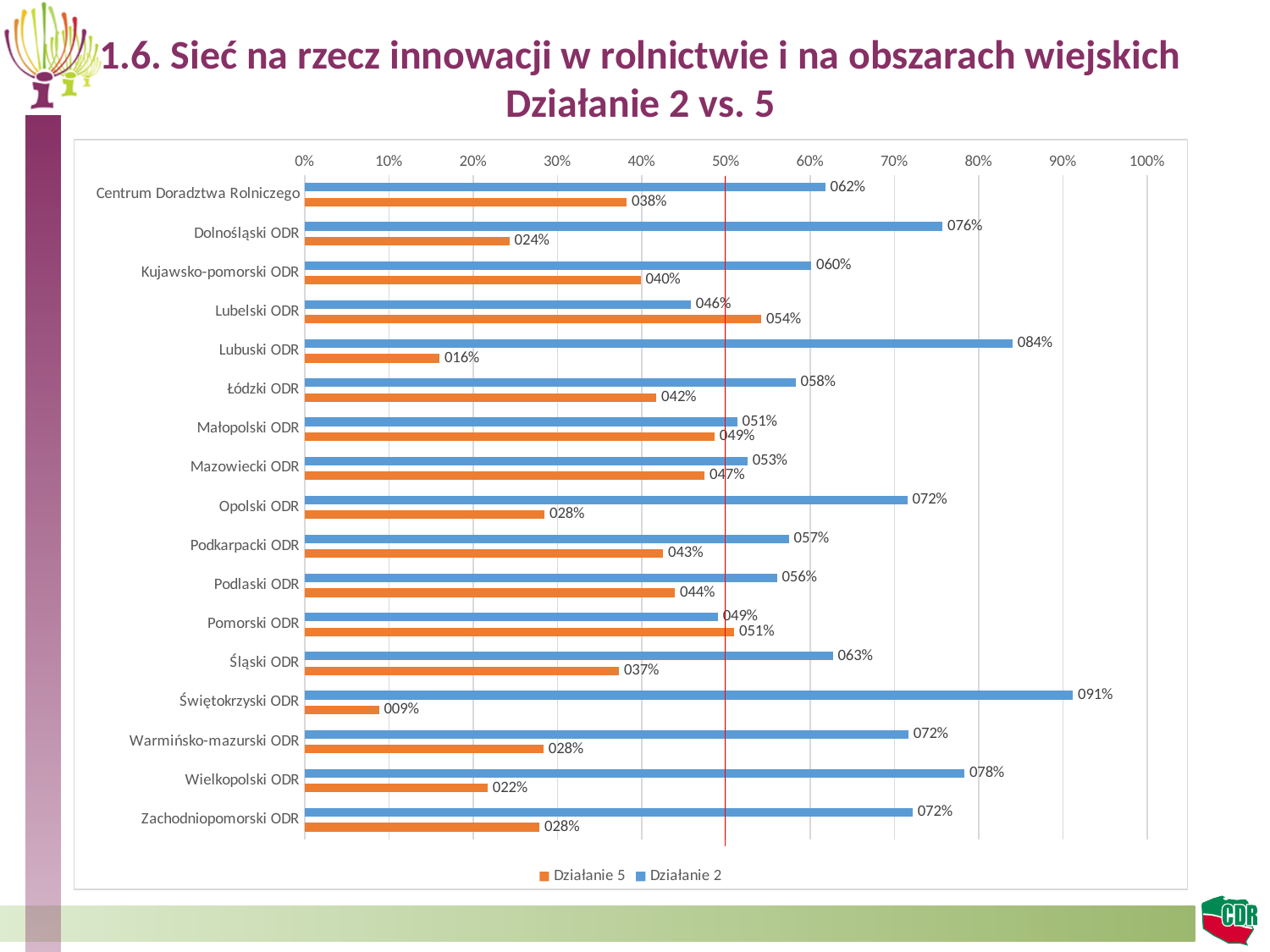
Which category has the highest Działanie 2 value? Świętokrzyski ODR What is the Działanie 5 value for Lubelski ODR? 054% What is the difference between the Działanie 2 and Działanie 5 values for Lubuski ODR? 068% What is the Działanie 2 value for Świętokrzyski ODR? 091% Which category has the lowest Działanie 2 value? Lubelski ODR What kind of chart is shown on the slide? Bar chart Which category has the lowest Działanie 5 value? Świętokrzyski ODR What is the Działanie 5 value for Centrum Doradztwa Rolniczego? 038% Which is larger for Pomorski ODR: the Działanie 2 value or the Działanie 5 value? Działanie 5 How many series does the legend list? 2 How many categories are shown on the chart? 17 Is the Działanie 2 value for Wielkopolski ODR greater or less than 70%? greater